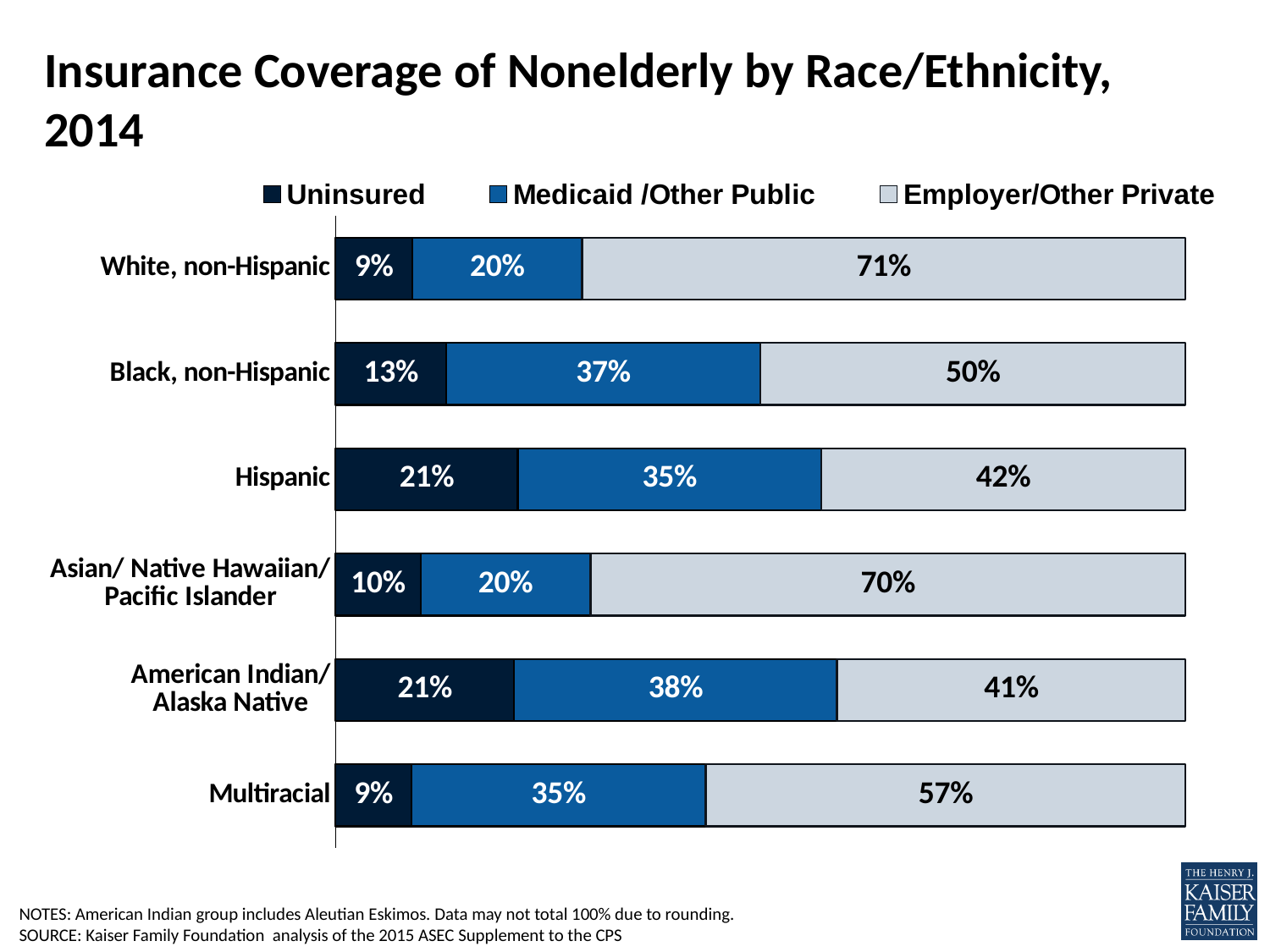
How many race/ethnicity groups are shown in the chart? 6 What is the total of the three segments for the White, non-Hispanic bar? 100% How many percentage points higher is the Employer/Other Private share for White, non-Hispanic than for Hispanic? 29 percentage points What type of chart is shown on the slide? Stacked bar chart What is the Employer/Other Private value for Multiracial? 57% How many series does the legend list? 3 Which group has the lowest Employer/Other Private share? American Indian/ Alaska Native Which group has the highest Medicaid /Other Public share? American Indian/ Alaska Native What percentage of Hispanic nonelderly are Uninsured? 21% Which group has a larger Uninsured share, Black, non-Hispanic or Asian/ Native Hawaiian/ Pacific Islander? Black, non-Hispanic What is the Medicaid /Other Public share for Black, non-Hispanic? 37% Which race/ethnicity group has the highest Employer/Other Private share? White, non-Hispanic